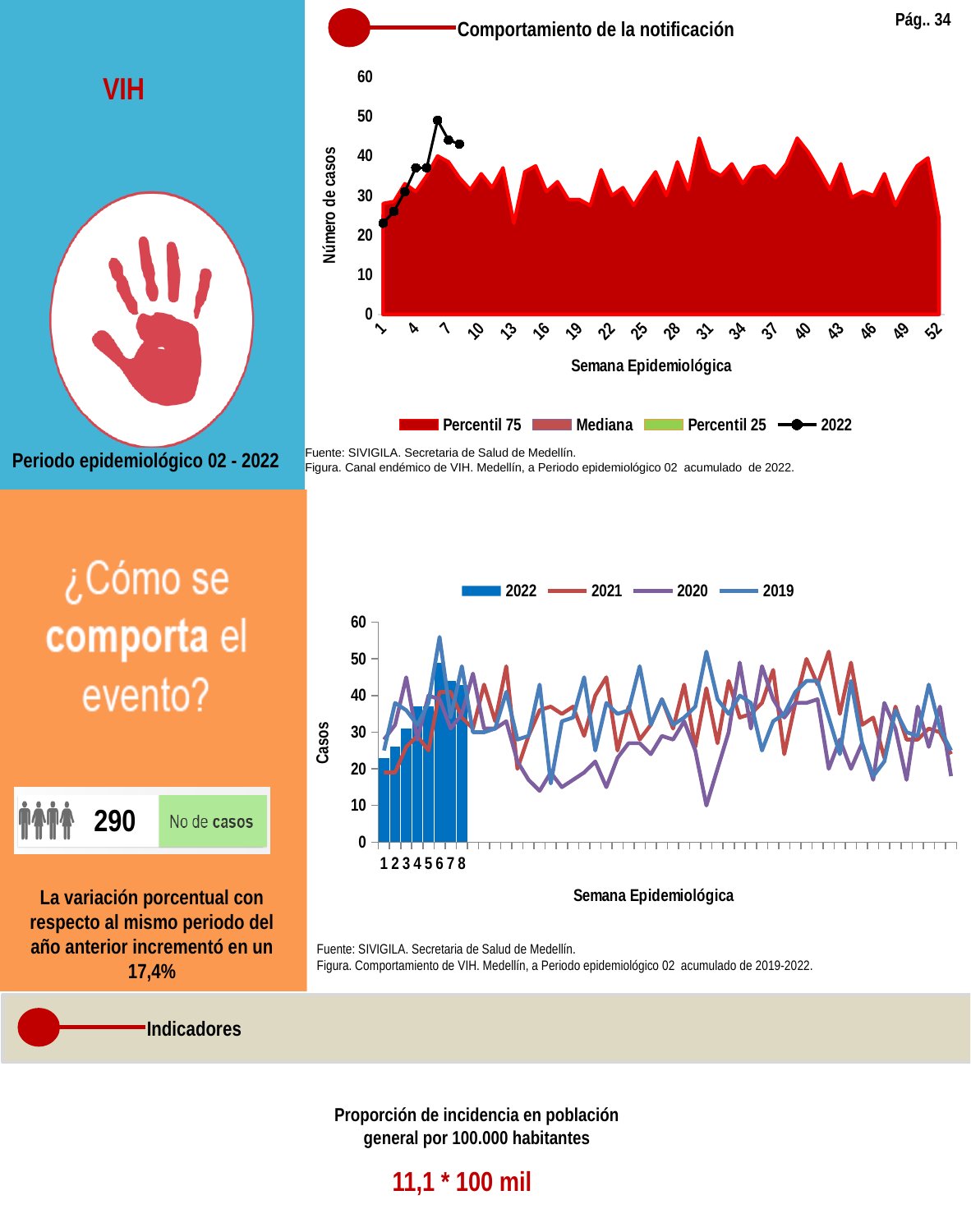
In the bottom chart, is the 2022 bar for week 6 greater or less than 40? greater In the top chart, is the 2022 value at week 6 greater or less than 40? greater In the top chart, at which week does the 2022 line reach its highest value? 6 In the bottom chart, how many series does the legend list? 4 In the top chart, what is the label of the y axis? Número de casos In the bottom chart, how many bars are plotted for 2022? 8 In the top chart, which series is drawn as a black line with markers? 2022 In the top chart, is the 2022 value at week 1 greater or less than 30? less In the bottom chart, which week has the shortest 2022 bar? 1 In the bottom chart, which week has the tallest 2022 bar? 6 In the top chart 'Comportamiento de la notificación', how many series does the legend list? 4 In the top chart, does the 2022 line rise or fall from week 1 to week 6? rises